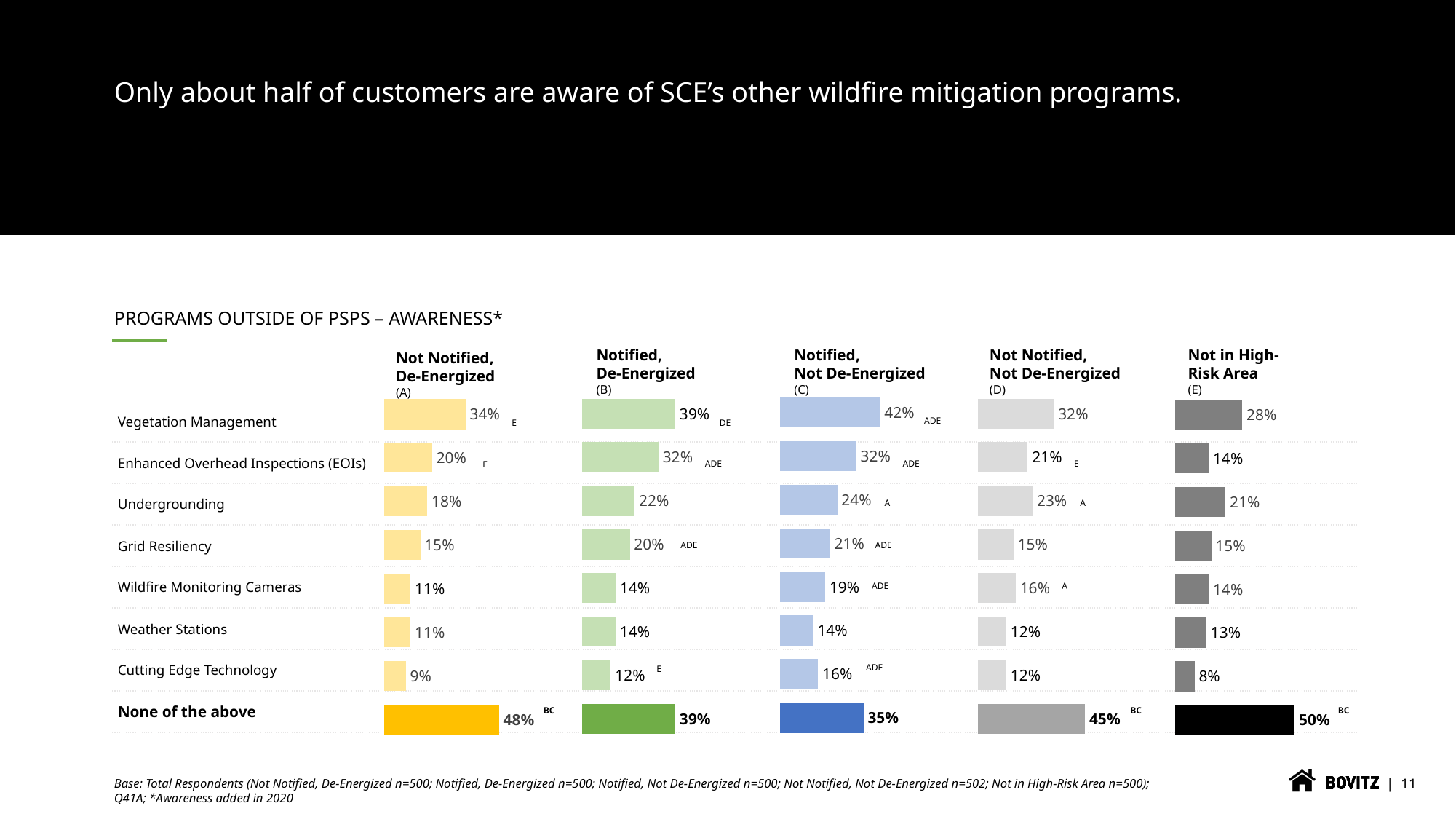
Which segment has the highest awareness of Vegetation Management? Notified, Not De-Energized What is the difference between None of the above for Not in High-Risk Area (50%) and Notified, Not De-Energized (35%)? 15% Which is larger: Enhanced Overhead Inspections awareness for Notified, De-Energized or for Not Notified, De-Energized? Notified, De-Energized Which program has the highest awareness among Notified, De-Energized customers? Vegetation Management What percentage of Notified, Not De-Energized customers are aware of Vegetation Management? 42% What percentage of Not Notified, De-Energized customers are aware of Cutting Edge Technology? 9% How many customer segments are shown as columns in the chart? 5 How many program rows (including None of the above) are shown in the chart? 8 Which program has the lowest awareness among Not in High-Risk Area customers? Cutting Edge Technology What is the difference between Vegetation Management awareness for Notified, Not De-Energized (42%) and Not in High-Risk Area (28%) customers? 14% What type of chart is used to show the awareness values? Bar chart What is the value for None of the above in the Not in High-Risk Area segment? 50%